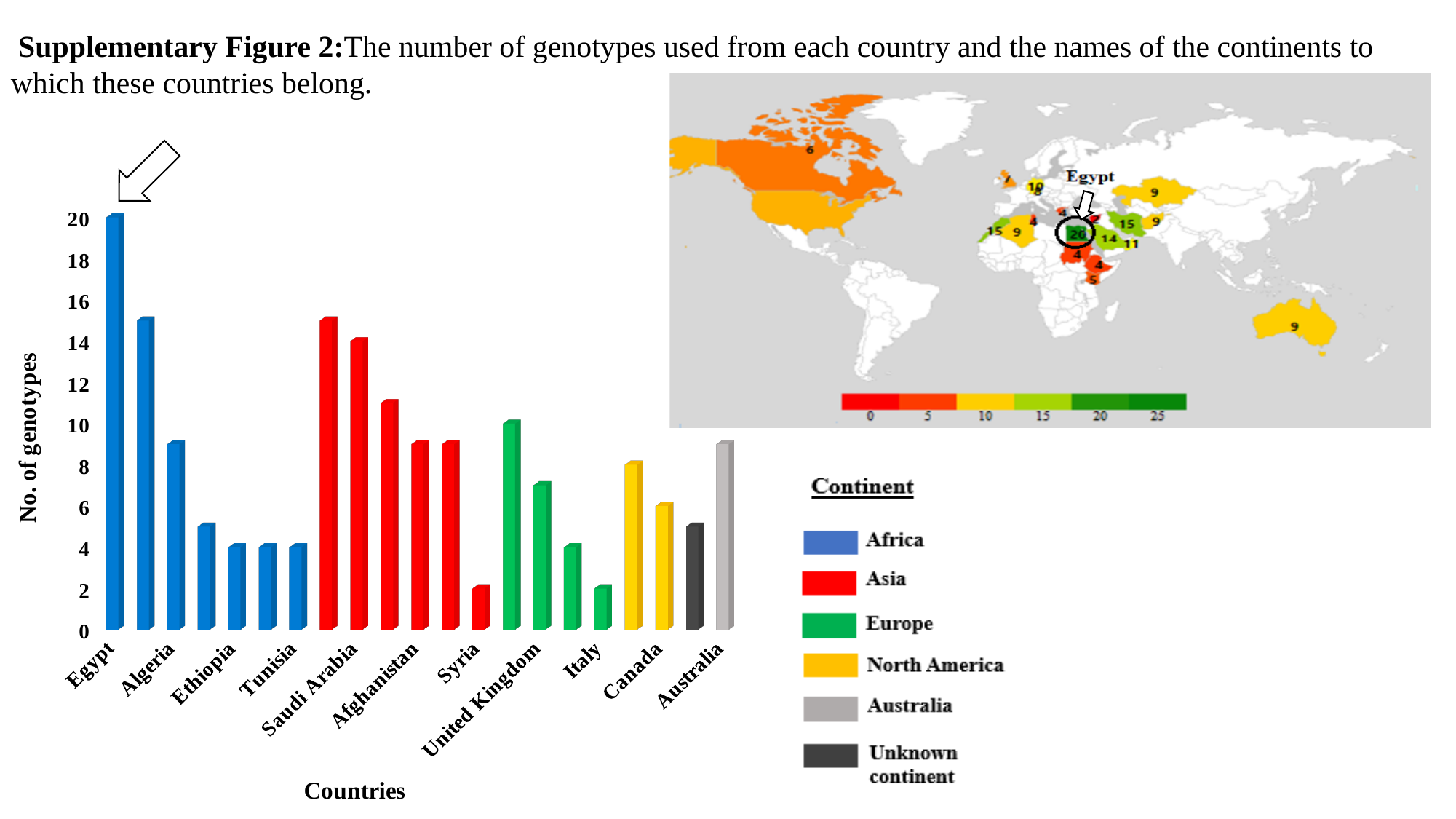
What is the difference in the number of genotypes between Egypt and Syria? 18 What kind of chart is used to show the number of genotypes per country? bar chart Which country has the highest number of genotypes in the bar chart? Egypt Is the number of genotypes for United Kingdom greater or less than 8? less Is the number of genotypes for Algeria greater or less than 8? greater How many genotypes are shown for Saudi Arabia in the bar chart? 14 How many continent categories does the legend list? 6 What colour represents Asia in the bar chart legend? red How many genotypes are shown for Syria in the bar chart? 2 How many genotypes are shown for Canada in the bar chart? 6 How many genotypes are shown for Egypt in the bar chart? 20 Which has more genotypes in the bar chart, Egypt or Saudi Arabia? Egypt